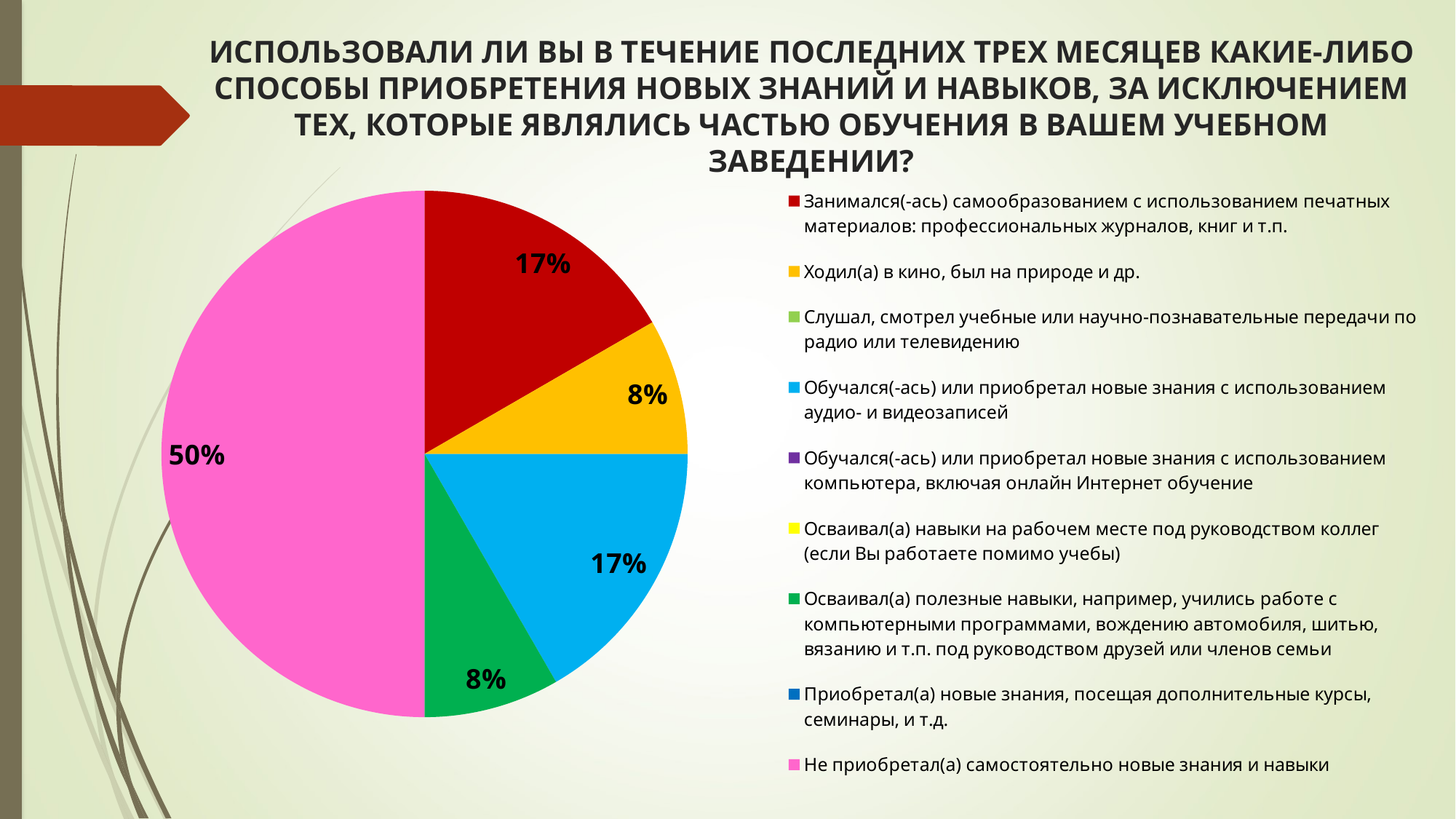
What kind of chart is shown on the slide? pie chart What percentage is shown for "Осваивал(а) полезные навыки ... под руководством друзей или членов семьи"? 8% How many entries does the legend list? 9 What percentage is shown for "Занимался(-ась) самообразованием с использованием печатных материалов"? 17% How many slices with data labels are visible in the pie? 5 Which category has the largest slice of the pie? Не приобретал(а) самостоятельно новые знания и навыки What percentage is shown for "Ходил(а) в кино, был на природе и др."? 8% What is the difference between the share for "Не приобретал(а) самостоятельно новые знания и навыки" and the share for "Ходил(а) в кино, был на природе и др."? 42% What colour is the slice for "Не приобретал(а) самостоятельно новые знания и навыки"? pink What percentage is shown for "Обучался(-ась) или приобретал новые знания с использованием аудио- и видеозаписей"? 17% Which is larger: the slice for "Занимался(-ась) самообразованием с использованием печатных материалов" or the slice for "Ходил(а) в кино, был на природе и др."? Занимался(-ась) самообразованием с использованием печатных материалов What percentage of the pie corresponds to "Не приобретал(а) самостоятельно новые знания и навыки"? 50%